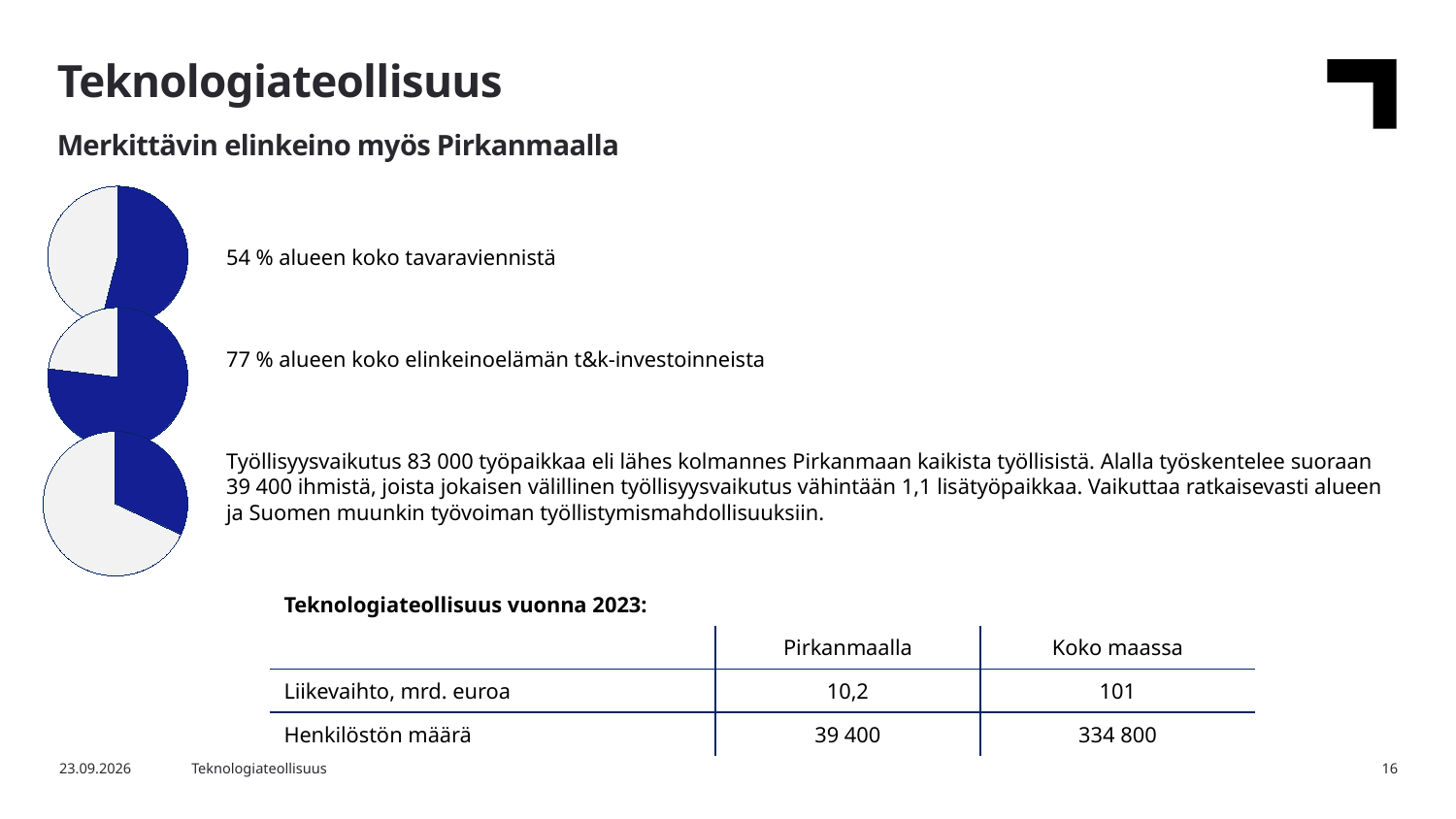
In the middle pie chart, what share does the blue slice represent according to the text next to it? 77 % In the top pie chart, what share does the blue slice represent according to the text next to it? 54 % What does the blue slice of the top pie chart represent, according to the text beside it? 54 % alueen koko tavaraviennistä Which pie chart has the larger blue slice, the top one or the middle one? The middle one How many pie charts are on the slide? 3 Which of the three pie charts has the smallest blue slice? The bottom one What kind of charts are shown on the left side of the slide? Pie charts What is the difference in percentage points between the blue shares of the middle pie chart (77 %) and the top pie chart (54 %)? 23 percentage points In the middle pie chart, is the blue slice greater or less than 50 % of the pie? greater What two colours are used in the pie charts? Blue and light grey In the bottom pie chart, is the blue slice greater or less than 50 % of the pie? less Which of the three pie charts has the largest blue slice? The middle one (77 %)